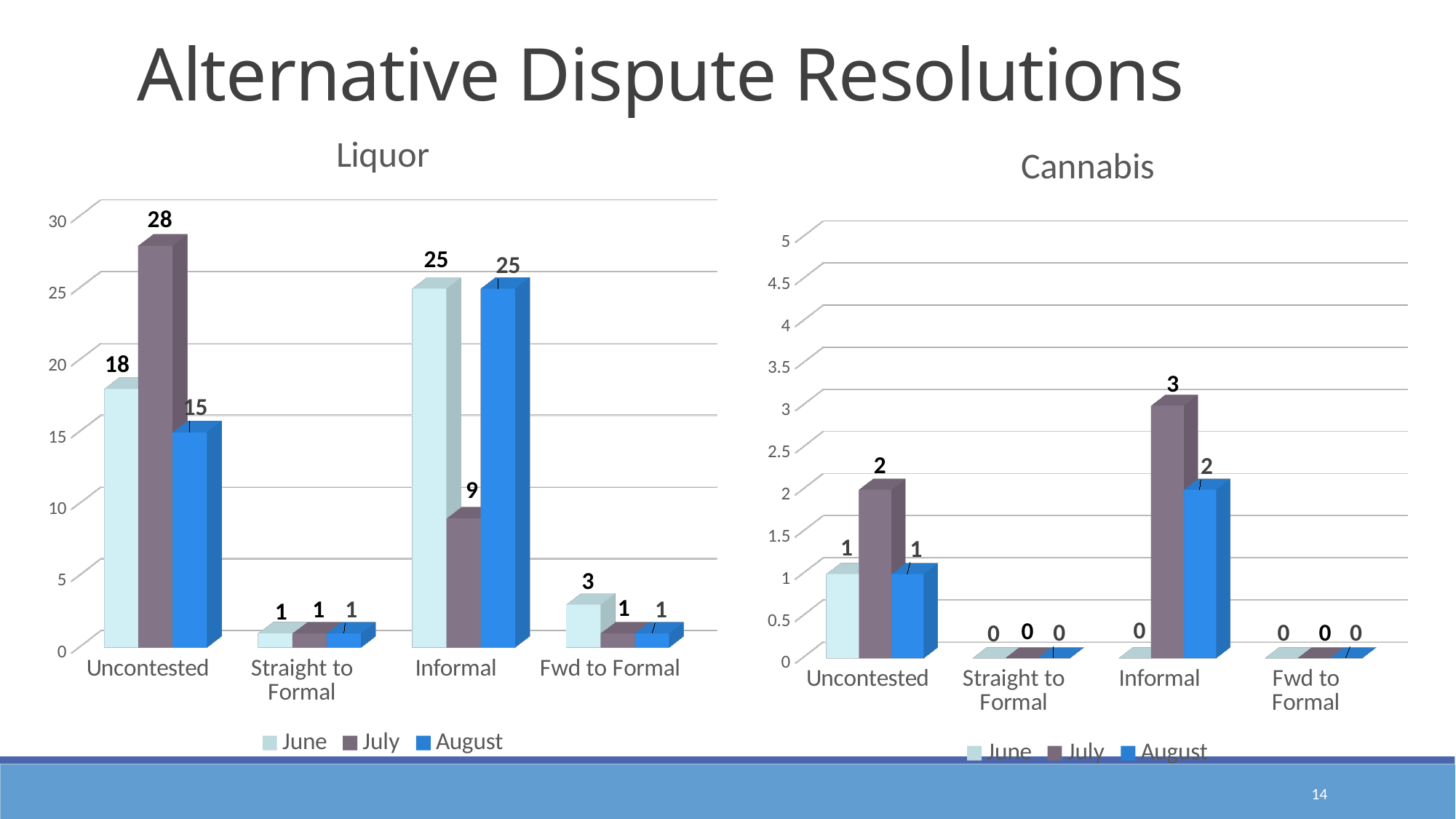
In the Liquor chart, how many series does the legend list? 3 In the Cannabis chart, what is the difference between the July and August values for Informal? 1 In the Liquor chart, which category has the highest July value? Uncontested In the Cannabis chart, what is the value for July in the Informal category? 3 In the Liquor chart, what is the value for July in the Uncontested category? 28 What kind of chart is the Cannabis chart? Bar chart In the Liquor chart, what is the difference between the June and July values for Informal? 16 In the Cannabis chart, how many categories are shown on the x axis? 4 In the Cannabis chart, what is the value for June in the Uncontested category? 1 In the Liquor chart, which is larger for Uncontested: the June value or the August value? June In the Liquor chart, what is the value for August in the Informal category? 25 In the Cannabis chart, which category has the highest August value? Informal